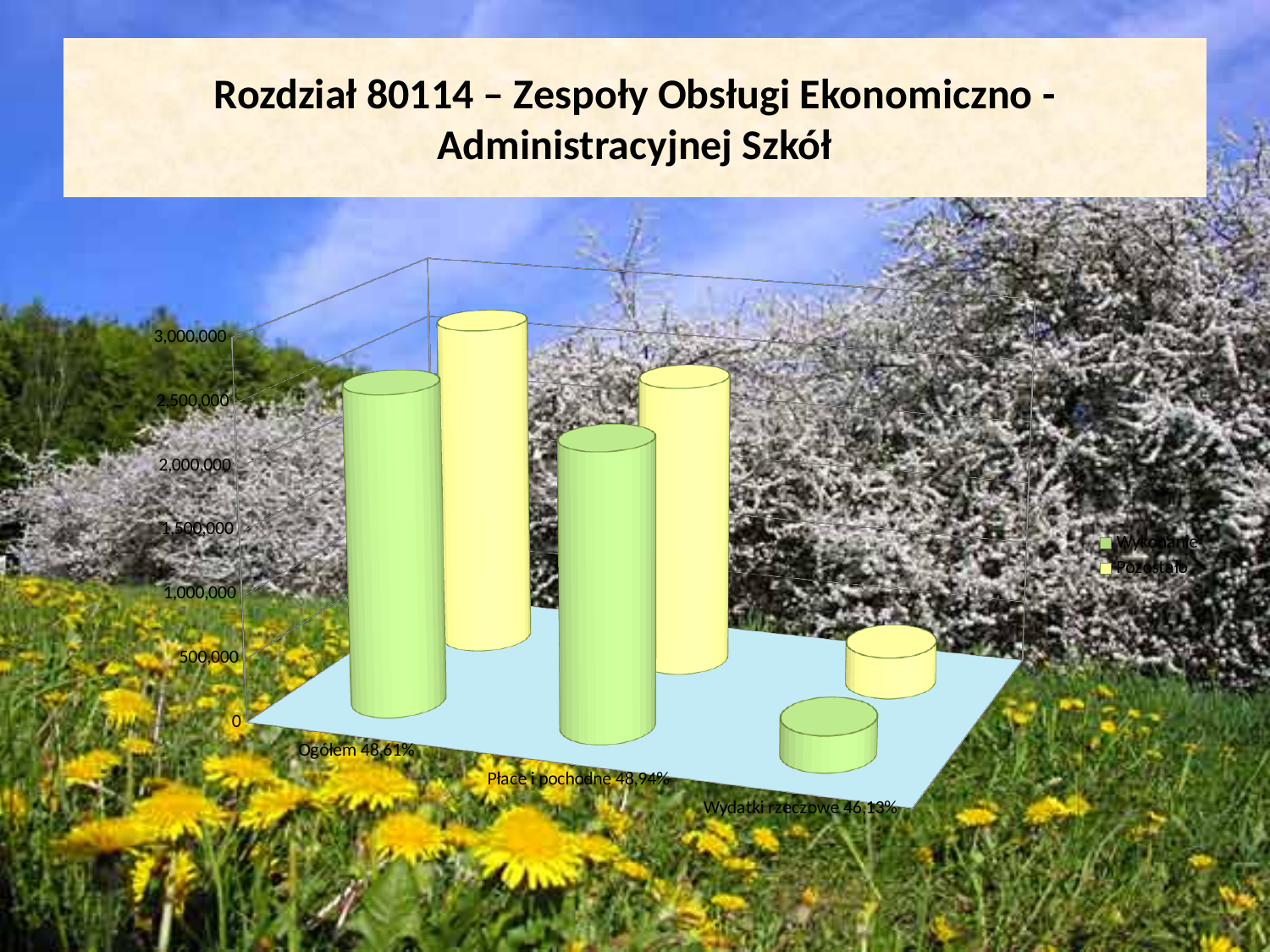
What percentage is printed in the category label for Wydatki rzeczowe? 46,13% How many series does the chart legend list? 2 Is the Wykonanie value for Wydatki rzeczowe greater or less than 500,000? less Is the Wykonanie value for Ogółem greater or less than 1,500,000? greater Which category has the highest Pozostało value? Ogółem Which category has the lowest Wykonanie value? Wydatki rzeczowe What percentage is printed in the category label for Ogółem? 48,61% What is the title of the slide containing the chart? Rozdział 80114 – Zespoły Obsługi Ekonomiczno - Administracyjnej Szkół What kind of chart is shown on the slide? bar chart How many categories are shown on the x axis of the chart? 3 Which is larger, the Wykonanie value for Płace i pochodne or the Wykonanie value for Wydatki rzeczowe? Płace i pochodne What are the two series named in the chart legend? Wykonanie and Pozostało